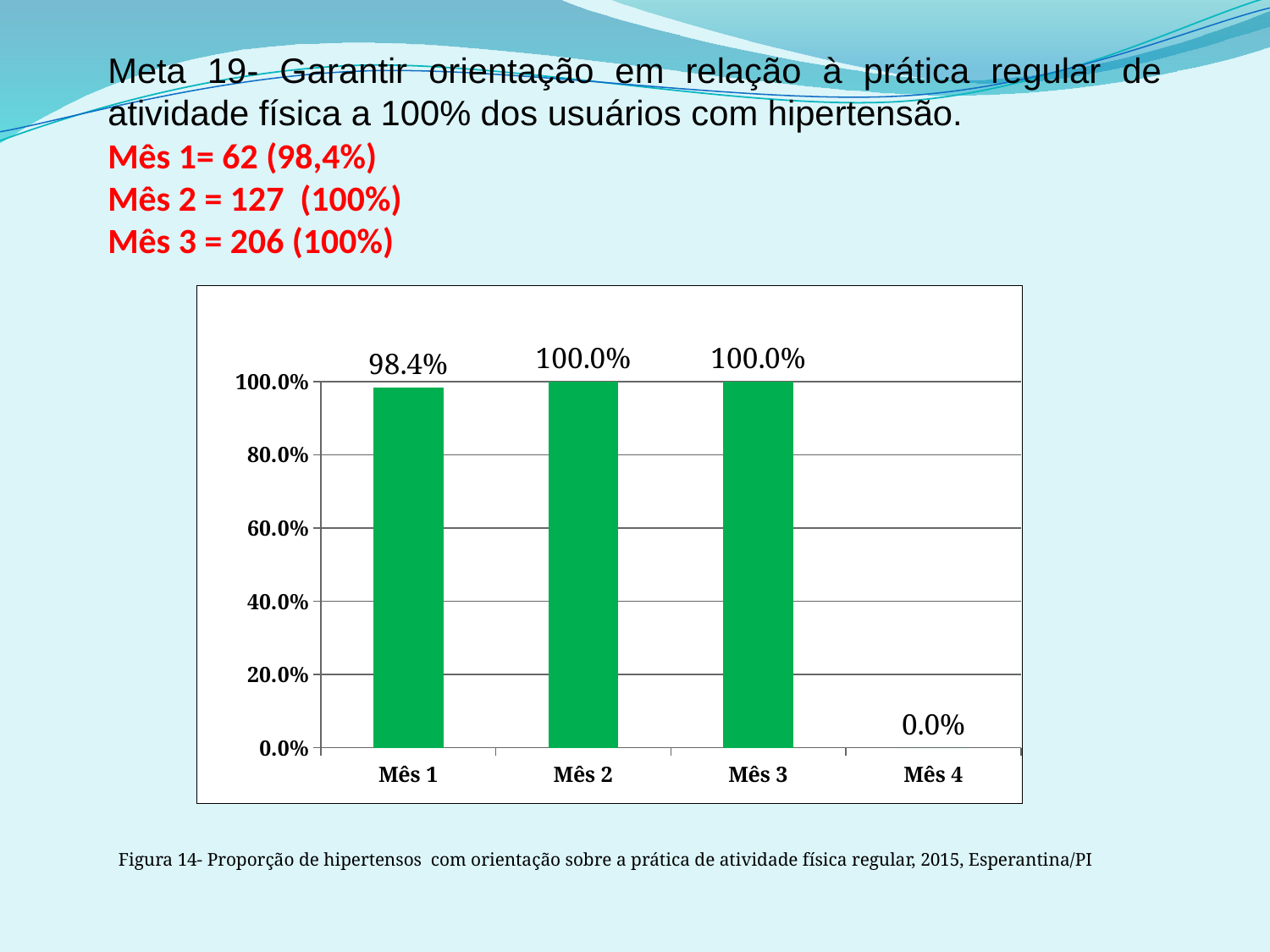
Which category has the lowest value? Mês 4 What is the value for Mês 4? 0.0% What is the value for Mês 1? 98.4% Is the value for Mês 1 greater or less than 80.0%? greater What is the figure number given in the caption below the chart? Figura 14 How many categories are shown on the x axis? 4 What is the difference between the values for Mês 3 and Mês 4? 100.0% What is the value for Mês 2? 100.0% What colour are the bars in the chart? green Which is larger, the value for Mês 3 or the value for Mês 1? Mês 3 What is the difference between the values for Mês 2 and Mês 1? 1.6% What kind of chart is shown on the slide? bar chart